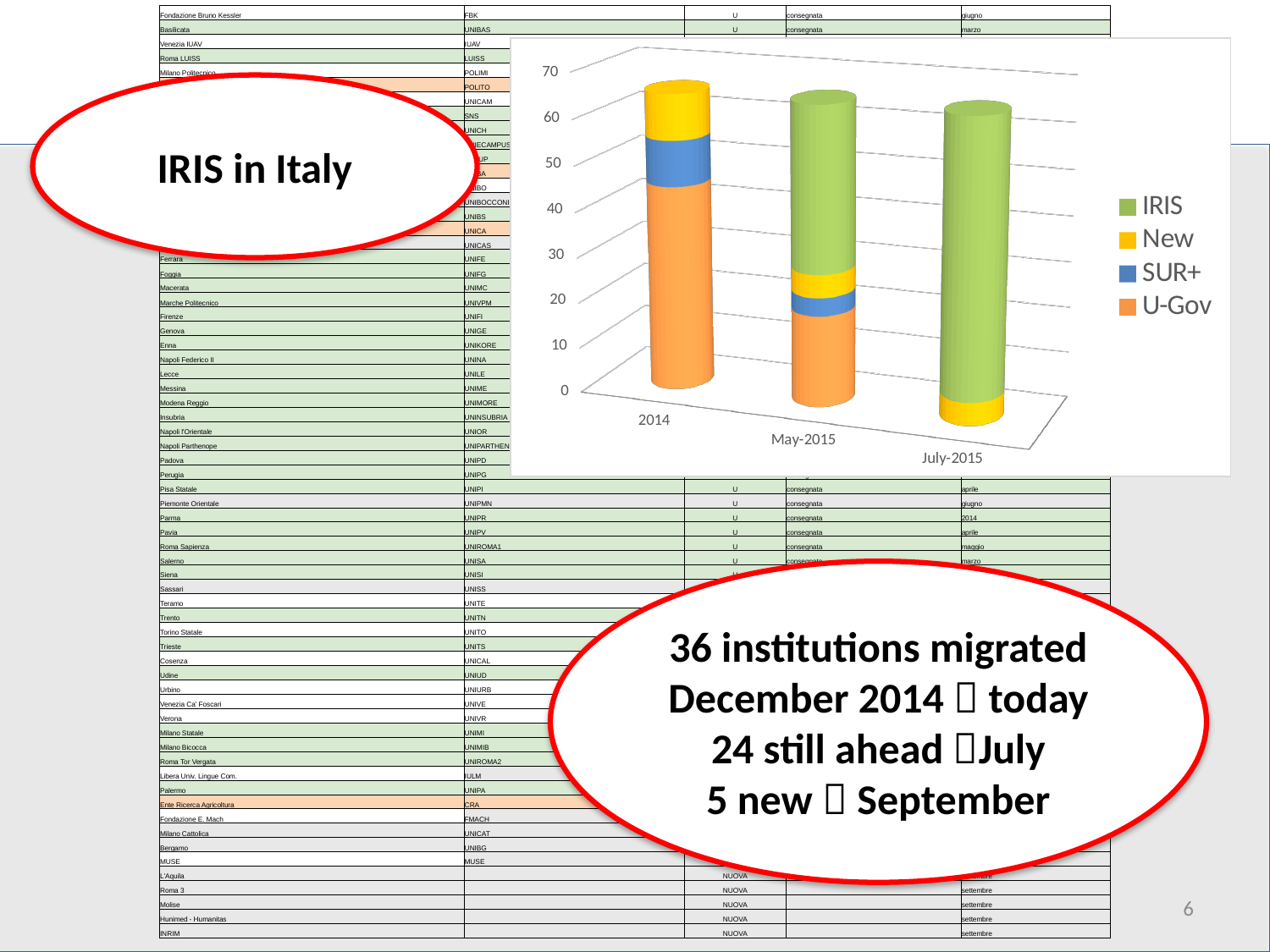
Which is larger, the IRIS segment in May-2015 or the IRIS segment in July-2015? July-2015 Is the total height of the 2014 bar greater or less than 50? greater Does the IRIS segment rise or fall from May-2015 to July-2015? rise Does the U-Gov segment rise or fall from 2014 to July-2015? fall Which category has the largest IRIS segment? July-2015 Which series is shown in orange in the chart legend? U-Gov Is the U-Gov segment of the May-2015 bar greater or less than 40? less How many categories are shown along the x axis of the chart? 3 Which series is shown in green in the chart legend? IRIS What kind of chart is shown on the slide? Stacked bar chart How many series does the chart legend list? 4 Which is larger, the U-Gov segment in 2014 or the U-Gov segment in May-2015? 2014